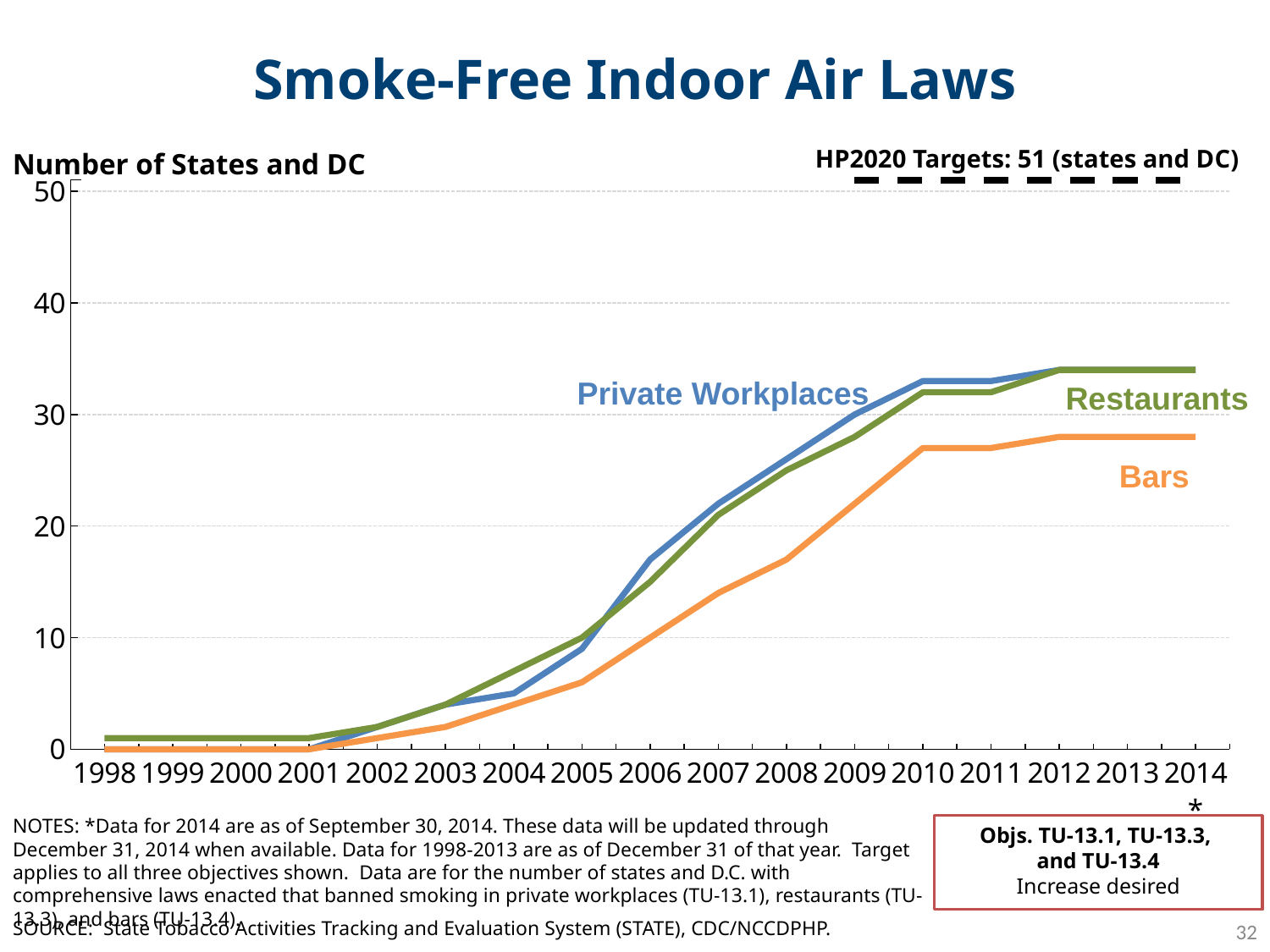
How many years are shown along the x axis of the chart? 17 What is the HP2020 target value shown on the chart? 51 In 2014, which series has the lowest value? Bars Is the value for Private Workplaces in 2007 greater or less than 20? greater Is the value for Restaurants in 2010 greater or less than 30? greater Is the value for Bars in 2014 greater or less than 30? less How many data series (lines) are plotted on the chart? 4 In 2008, which is larger: the value for Private Workplaces or the value for Bars? Private Workplaces Does the Bars line generally rise or fall from 1998 to 2014? rise What kind of chart is shown on the slide? line chart